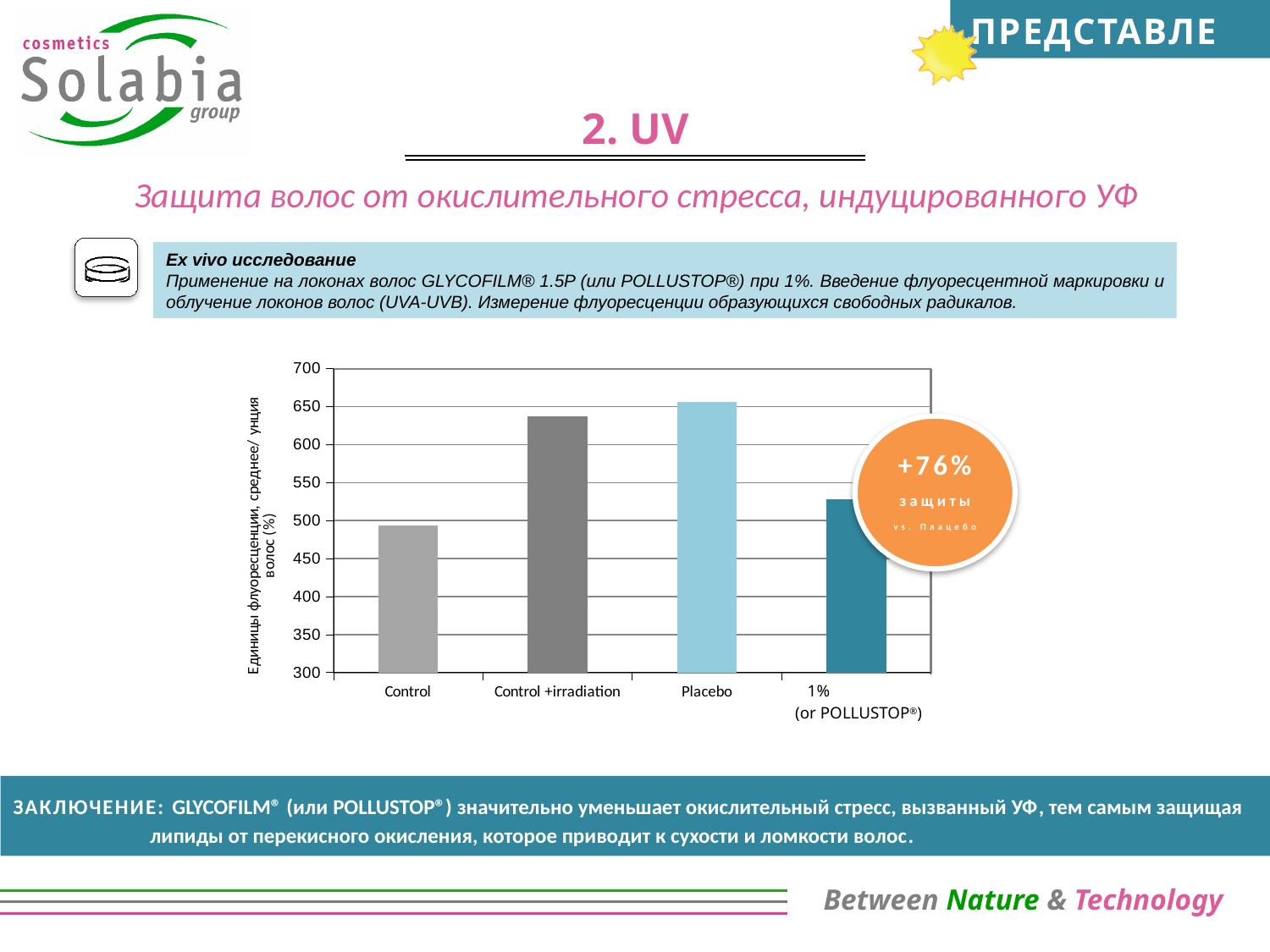
Is the value for Placebo greater or less than 600? greater Is the value for Control +irradiation greater or less than 600? greater What is the lowest value shown on the y axis of the chart? 300 What kind of chart is shown on the slide? bar chart What percentage of protection versus placebo is stated in the orange circle on the chart? +76% Is the value for Control greater or less than 500? less Which is larger, the value for Placebo or the value for Control? Placebo Which category has the lowest bar in the chart? Control Which is larger, the value for Control +irradiation or the value for 1% (or POLLUSTOP®)? Control +irradiation How many categories are plotted on the x axis of the chart? 4